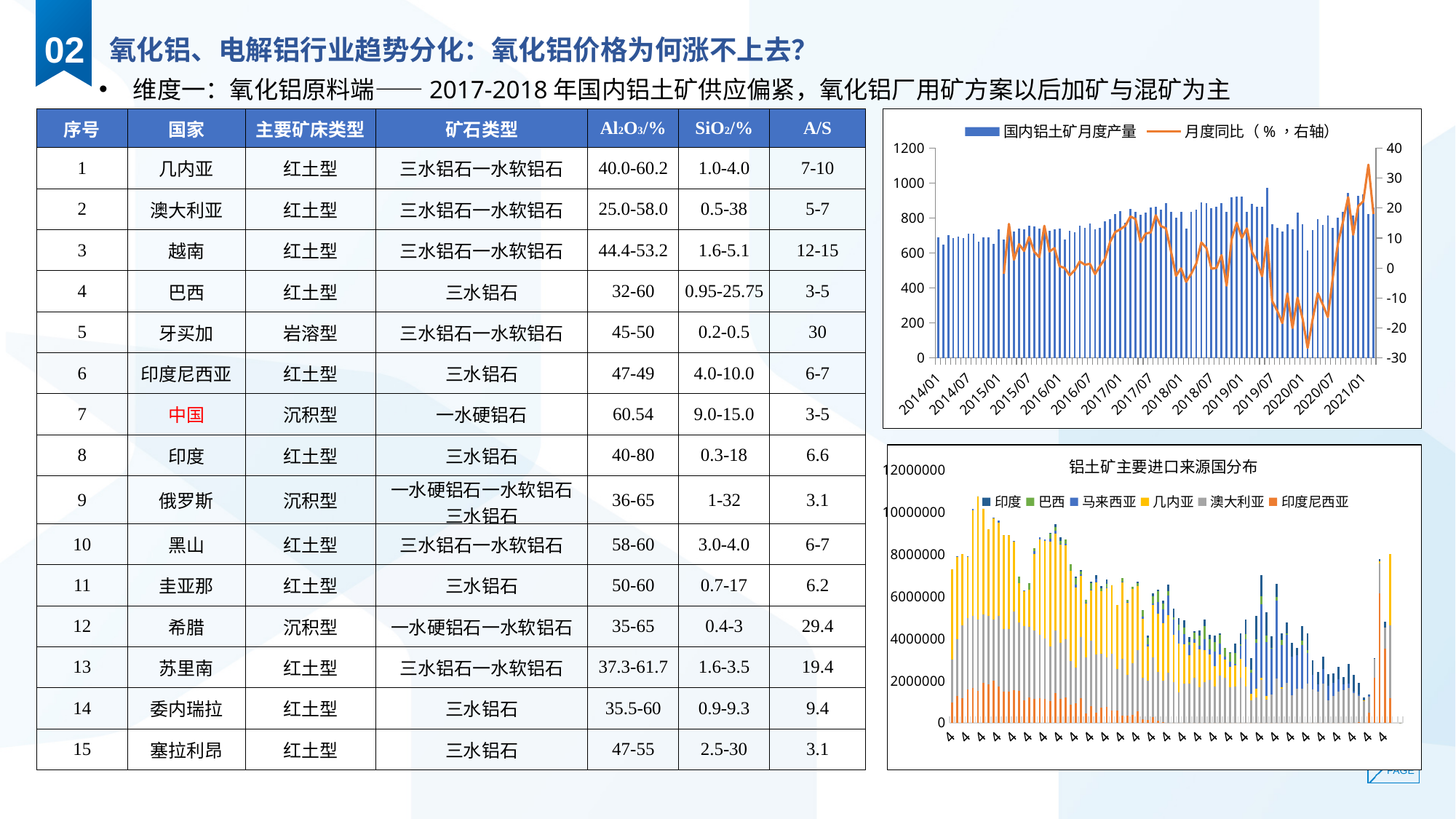
What is the maximum value shown on the vertical axis of the bottom-right chart (铝土矿主要进口来源国分布)? 12000000 What is the maximum value shown on the left axis of the top-right chart? 1200 How many series does the legend of the bottom-right chart (铝土矿主要进口来源国分布) list? 6 In the top-right chart, is the 国内铝土矿月度产量 bar for 2014/01 greater or less than 800? less In the bottom-right chart (铝土矿主要进口来源国分布), which series is shown in yellow? 几内亚 What kind of chart is the top-right chart titled 国内铝土矿月度产量? bar chart with a line In the top-right chart, is the 国内铝土矿月度产量 bar for 2019/01 greater or less than 800? greater How many series does the legend of the top-right chart (国内铝土矿月度产量) list? 2 What kind of chart is the bottom-right chart titled 铝土矿主要进口来源国分布? stacked bar chart